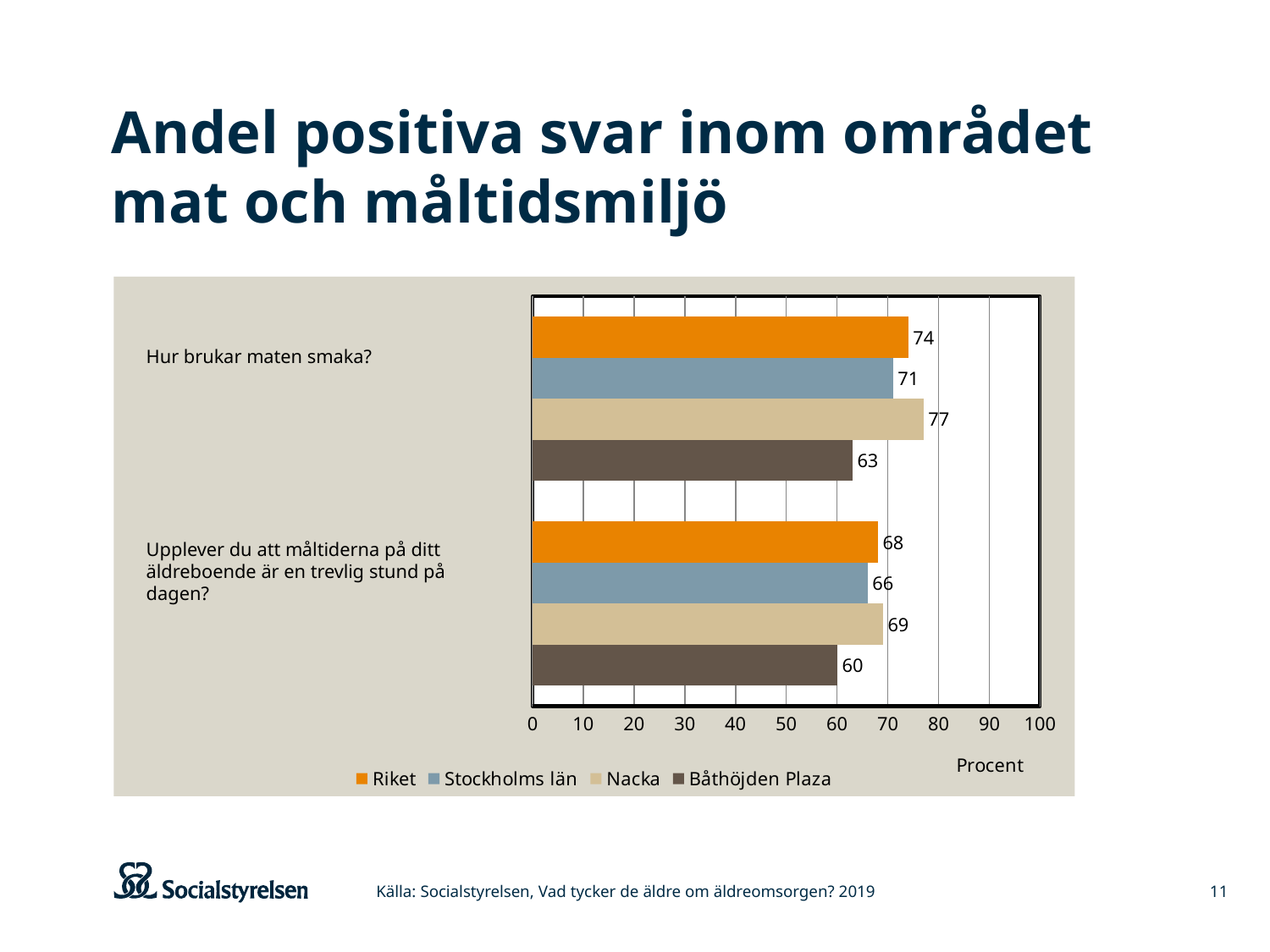
Which is larger for the question "Upplever du att måltiderna på ditt äldreboende är en trevlig stund på dagen?": Riket or Stockholms län? Riket Which series has the highest value for the question "Hur brukar maten smaka?"? Nacka Which series has the lowest value for the question "Upplever du att måltiderna på ditt äldreboende är en trevlig stund på dagen?"? Båthöjden Plaza What is the value for Stockholms län for the question "Upplever du att måltiderna på ditt äldreboende är en trevlig stund på dagen?"? 66 How many questions (categories) are shown on the chart? 2 What is the value for Båthöjden Plaza for the question "Upplever du att måltiderna på ditt äldreboende är en trevlig stund på dagen?"? 60 What is the label on the horizontal axis of the chart? Procent What is the value for Riket for the question "Hur brukar maten smaka?"? 74 How many series does the legend list? 4 What is the value for Nacka for the question "Hur brukar maten smaka?"? 77 What kind of chart is shown on the slide? Bar chart What is the difference between the Nacka and Båthöjden Plaza values for the question "Hur brukar maten smaka?"? 14